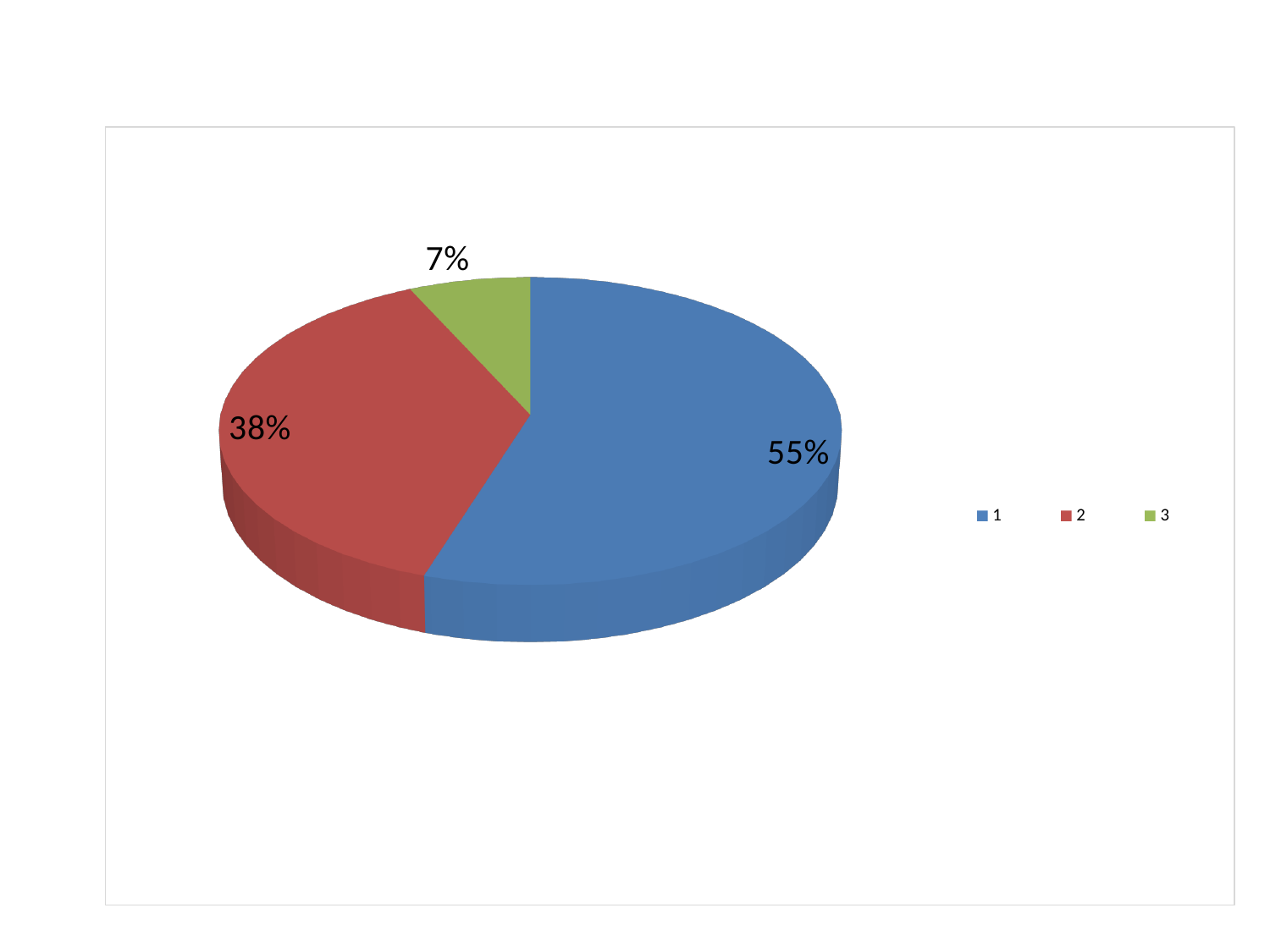
What share of the pie does category 2 have? 38% What share of the pie does category 3 have? 7% How many slices does the pie chart have? 3 How many entries does the legend list? 3 Which is larger, the slice for category 2 or the slice for category 3? 2 Which category has the smallest slice of the pie? 3 What colour is the slice for category 2? red What share of the pie does category 1 have? 55% What colour is the slice for category 3? green What kind of chart is shown on the slide? pie chart Which category has the largest slice of the pie? 1 What is the difference in percentage points between the slices for category 1 and category 2? 17